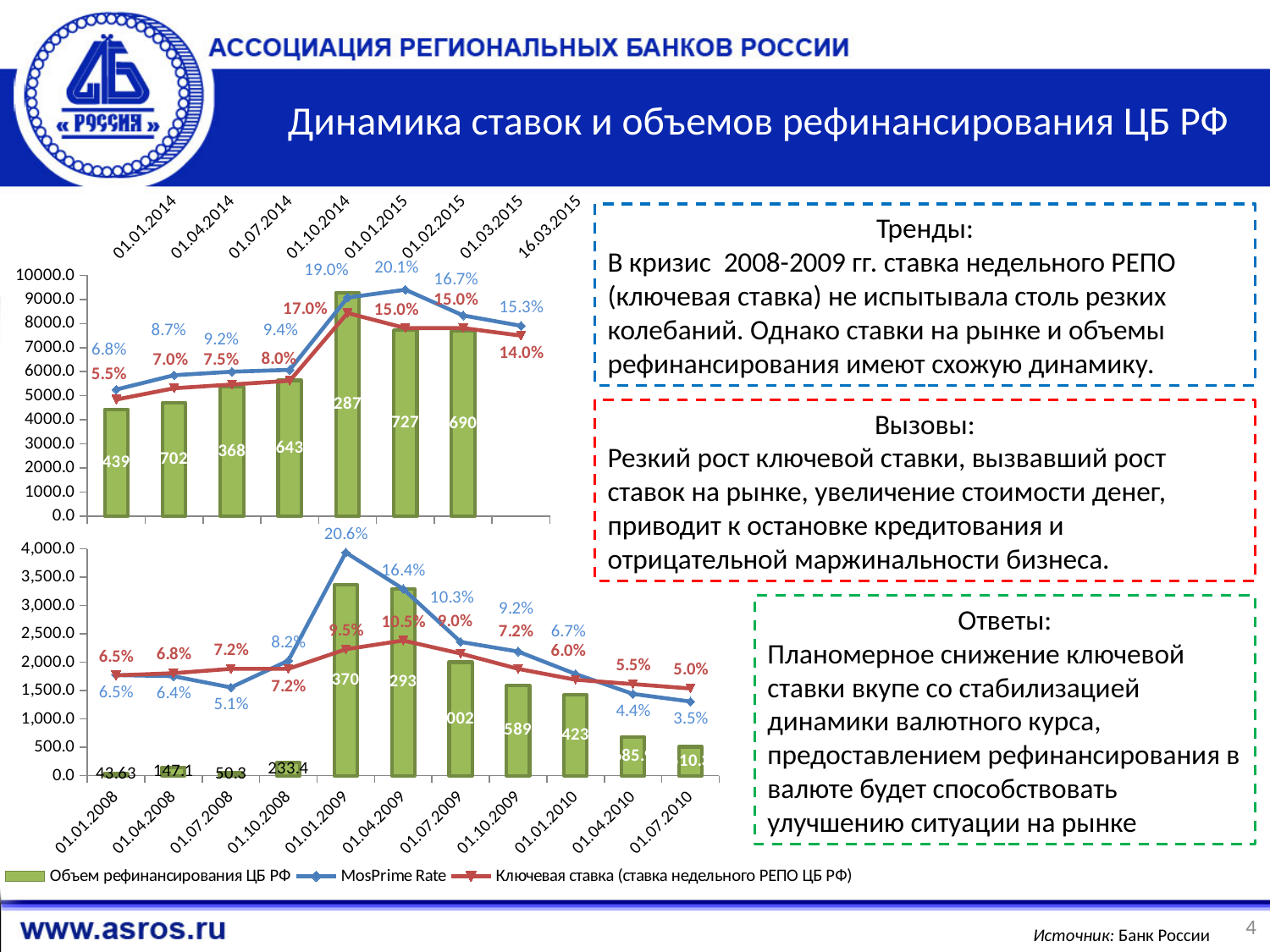
How many dates are shown on the x axis of the top chart? 8 On the bottom chart, on which date is the MosPrime Rate lowest? 01.07.2010 On the bottom chart, which is larger on 01.04.2009: the MosPrime Rate or the key rate? MosPrime Rate On the top chart, is the refinancing volume bar for 01.01.2015 greater or less than 8000.0? greater On the top chart, on which date is the MosPrime Rate highest? 01.02.2015 On the bottom chart, what is the key rate on 01.04.2009? 10.5% On the bottom chart, what is the MosPrime Rate on 01.01.2009? 20.6% On the top chart, what is the MosPrime Rate on 01.02.2015? 20.1% On the bottom chart, what is the refinancing volume (Объем рефинансирования ЦБ РФ) on 01.01.2008? 43.63 On the top chart, what is the difference between the MosPrime Rate and the key rate on 01.01.2014? 1.3 percentage points How many series does the legend at the bottom of the slide list? 3 On the top chart, what is the key rate (Ключевая ставка) on 01.01.2015? 17.0%